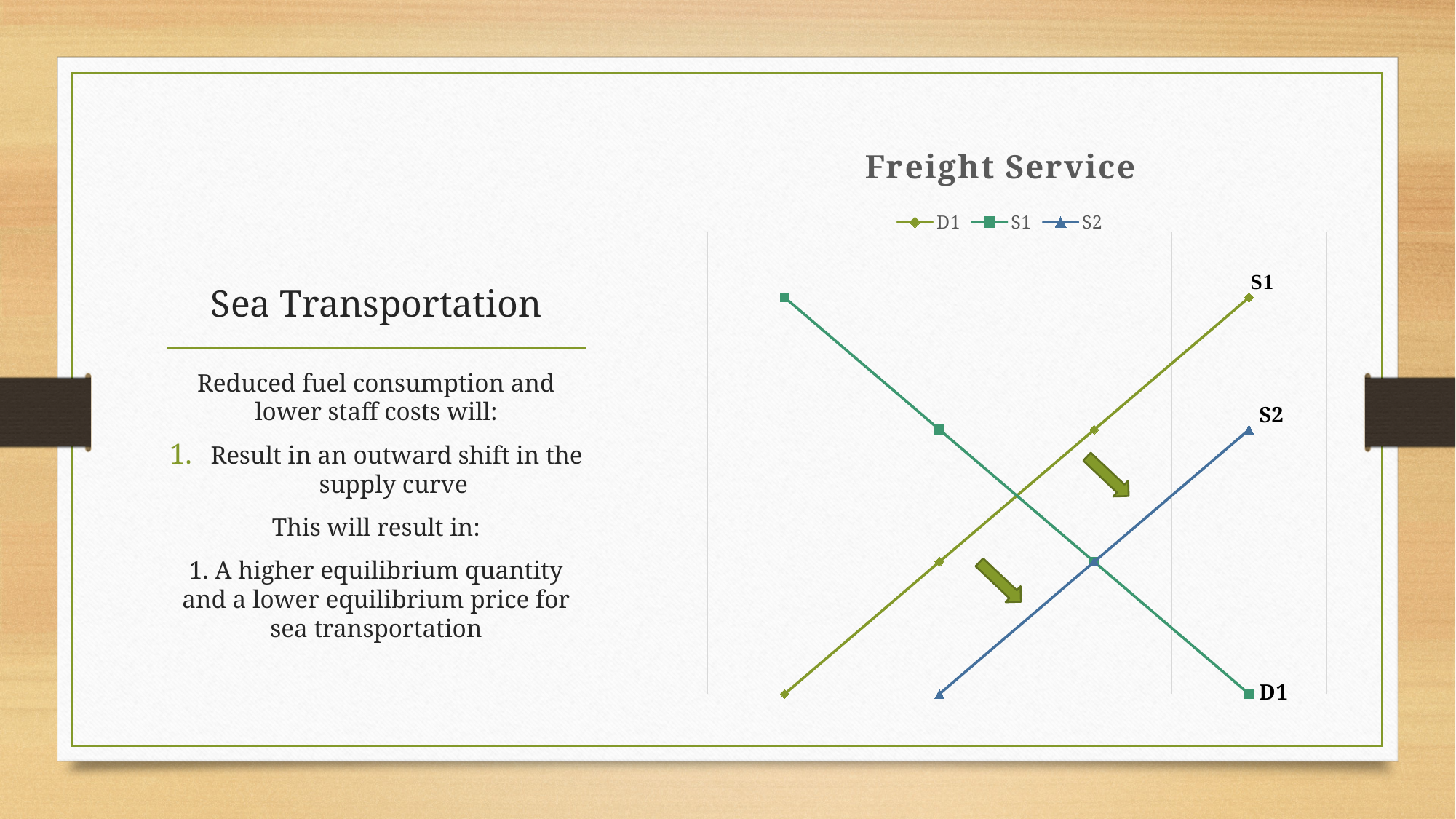
How many series does the chart's legend list? 3 Which series are listed in the chart's legend? D1, S1, S2 How many data points are plotted for the D1 series (diamond markers)? 4 Does the S2 series (triangle markers) rise or fall from left to right? rise Does the D1 series (diamond markers) rise or fall from left to right? rise Does the S1 series (square markers) rise or fall from left to right? fall How many data points are plotted for the S1 series (square markers)? 4 What kind of chart is shown on the slide? line chart At the leftmost point, which series is higher: D1 (diamond markers) or S1 (square markers)? S1 What is the title of the chart? Freight Service At the rightmost point, which series is higher: D1 (diamond markers) or S1 (square markers)? D1